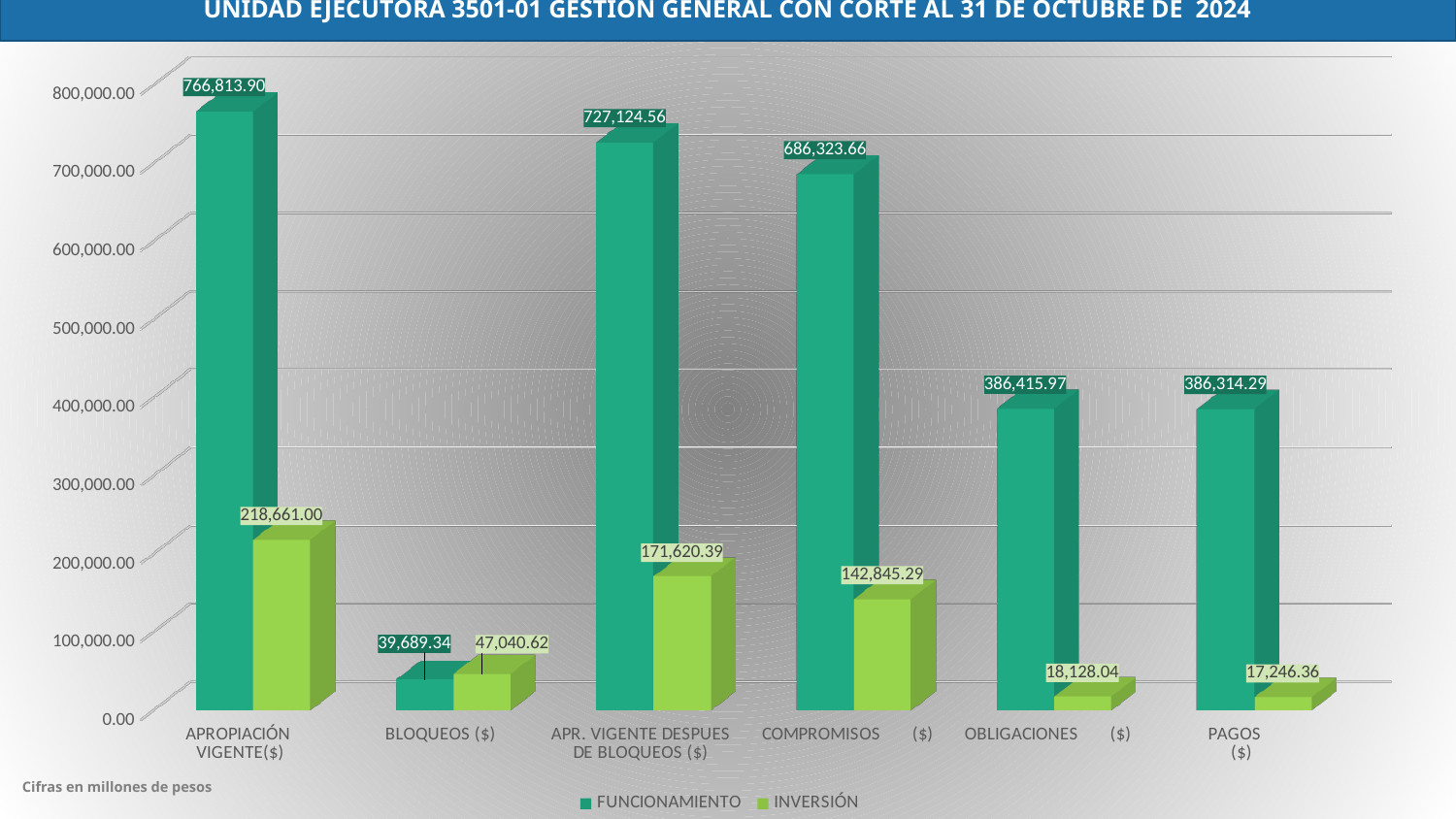
What is the FUNCIONAMIENTO value for PAGOS ($)? 386,314.29 Which category has the highest INVERSIÓN value? APROPIACIÓN VIGENTE($) How many categories are shown on the x axis? 6 For BLOQUEOS ($), which series has the larger value, FUNCIONAMIENTO or INVERSIÓN? INVERSIÓN Which category has the lowest FUNCIONAMIENTO value? BLOQUEOS ($) What is the INVERSIÓN value for COMPROMISOS ($)? 142,845.29 How many series does the legend list? 2 What is the difference between the FUNCIONAMIENTO values for APR. VIGENTE DESPUES DE BLOQUEOS ($) and COMPROMISOS ($)? 40,800.90 What is the FUNCIONAMIENTO value for APROPIACIÓN VIGENTE($)? 766,813.90 What kind of chart is shown on the slide? Bar chart What is the INVERSIÓN value for BLOQUEOS ($)? 47,040.62 What is the difference between the FUNCIONAMIENTO and INVERSIÓN values for APROPIACIÓN VIGENTE($)? 548,152.90